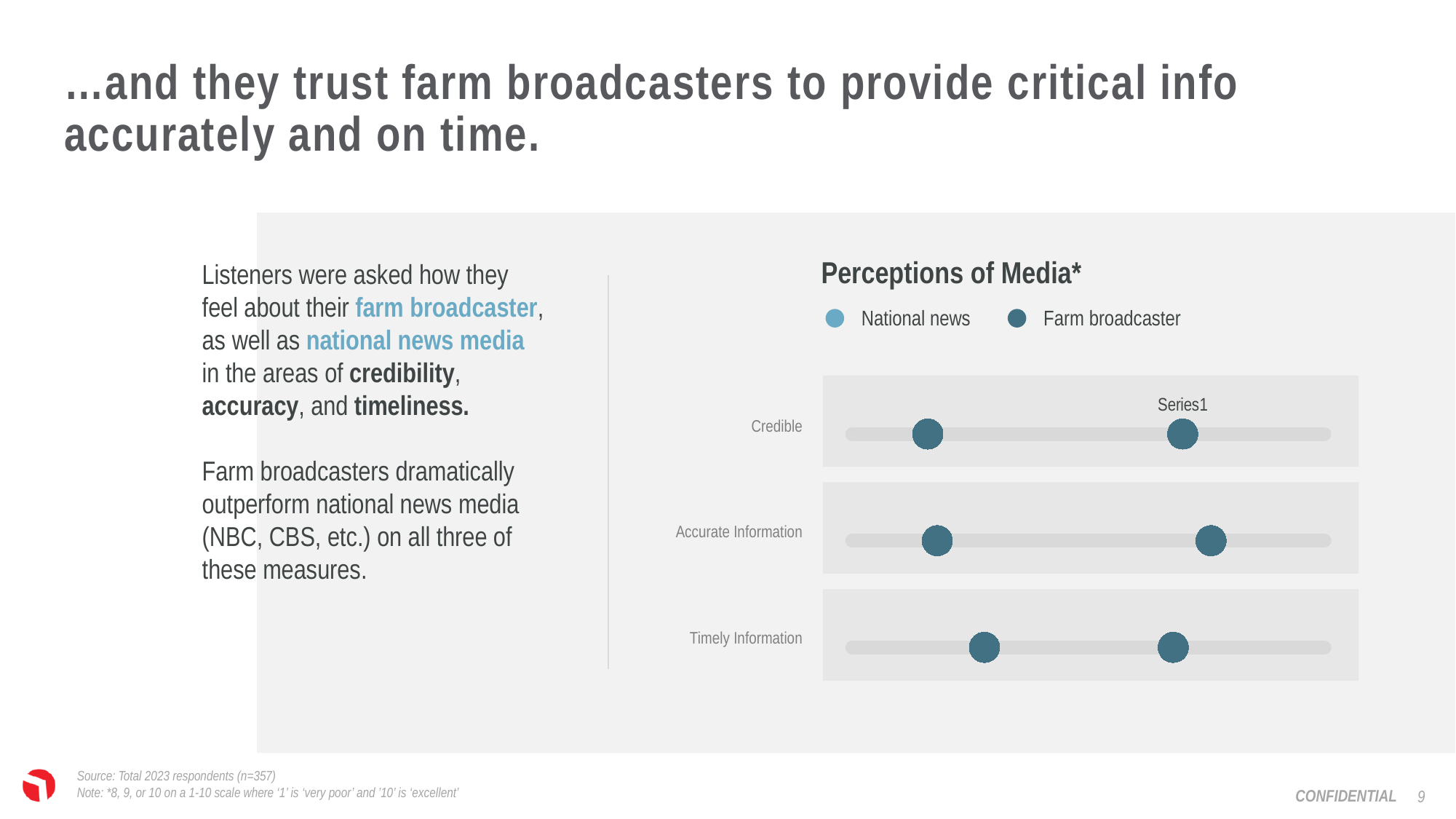
How many categories are shown on the chart's vertical axis? 3 In which category does the left-hand dot sit furthest to the right? Timely Information What is the title of the chart on the slide? Perceptions of Media* How many series does the chart legend list? 2 What are the two series named in the chart legend? National news and Farm broadcaster For which category are the two dots closest together? Timely Information In which category does the right-hand dot sit furthest to the right? Accurate Information What kind of chart is shown on the slide? Dot plot